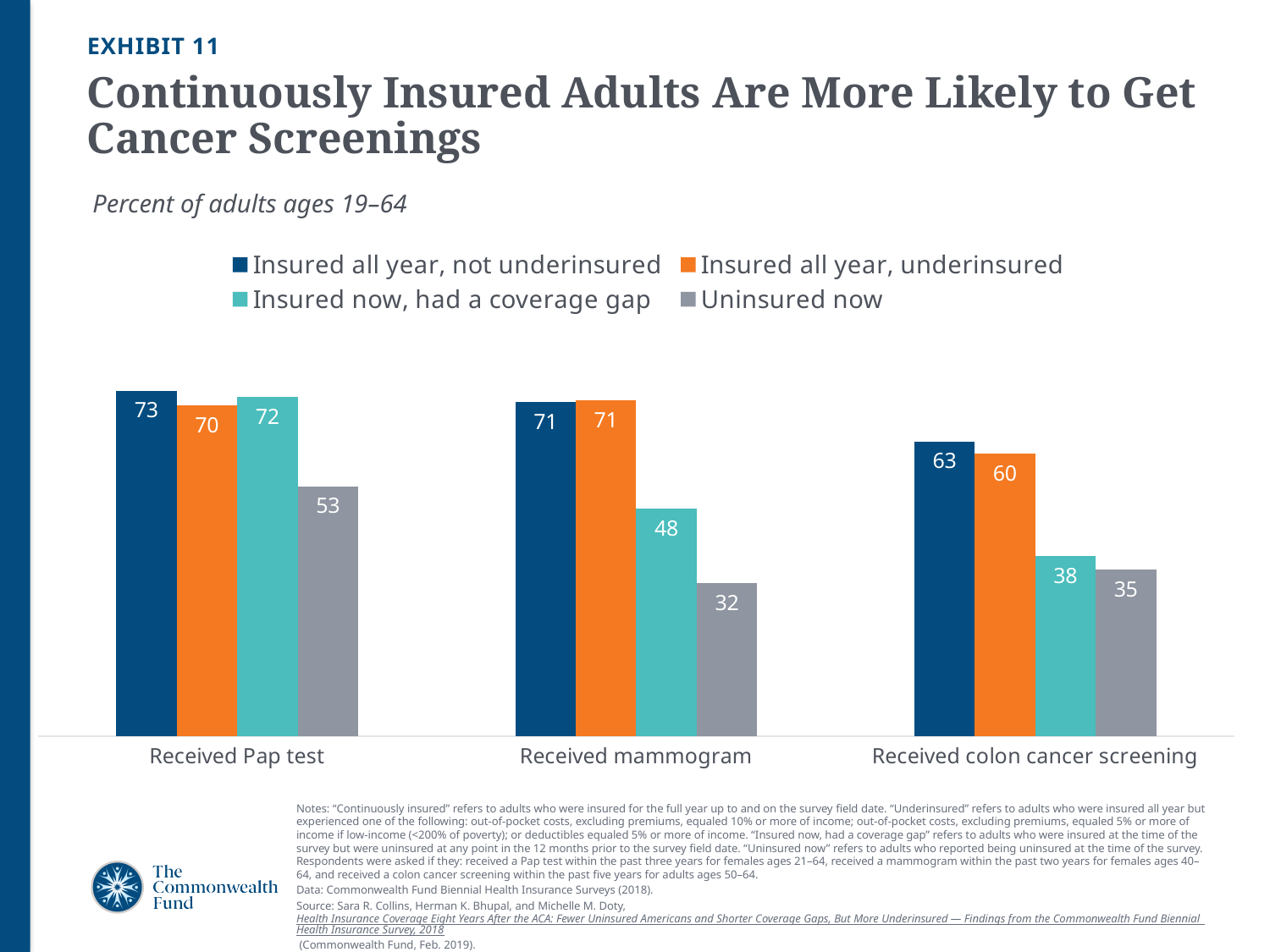
What percent of adults who were insured all year, not underinsured, received a Pap test? 73 What is the difference between the Insured all year, not underinsured value and the Insured all year, underinsured value for Received colon cancer screening? 3 What percent of adults who were insured now, had a coverage gap, received a colon cancer screening? 38 Which legend entry is shown in orange? Insured all year, underinsured What is the difference between the Insured all year, underinsured value and the Uninsured now value for Received mammogram? 39 What percent of adults who were uninsured now received a mammogram? 32 For Received Pap test, which is larger: the value for Insured now, had a coverage gap, or the value for Uninsured now? Insured now, had a coverage gap Which insurance group has the highest value for Received Pap test? Insured all year, not underinsured How many series does the legend list? 4 What kind of chart is shown on the slide? Bar chart Which insurance group has the lowest value for Received colon cancer screening? Uninsured now How many screening categories are shown on the x axis? 3